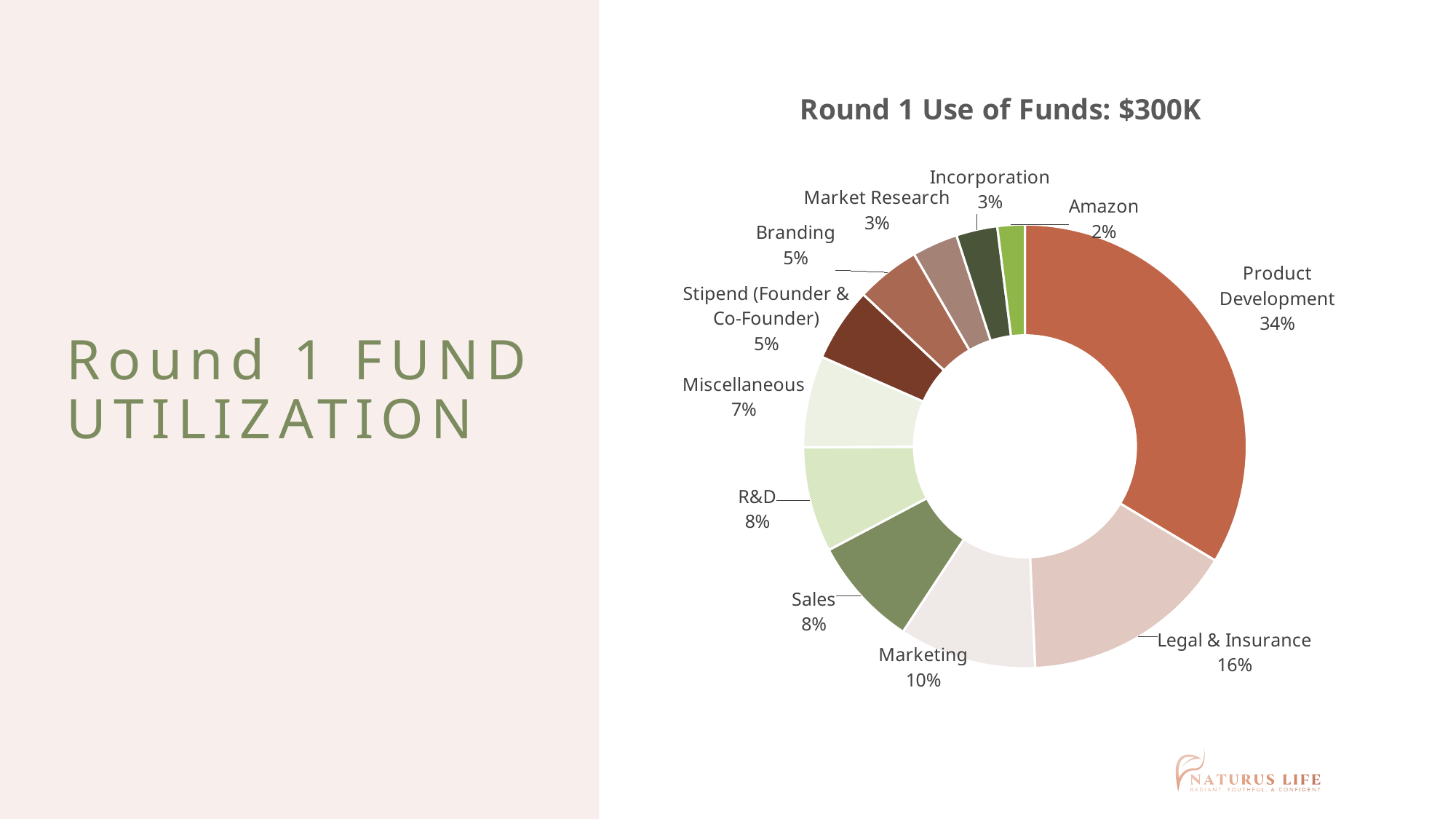
Which receives a larger share of funds, Marketing or Miscellaneous? Marketing What percentage of the funds is allocated to Legal & Insurance? 16% What share of Round 1 funds goes to Product Development? 34% Which category receives the largest share of Round 1 funds? Product Development Which category receives the smallest share of Round 1 funds? Amazon What type of chart is shown on the slide? Doughnut chart What is the combined share of Sales and R&D? 16% What is the title of the chart? Round 1 Use of Funds: $300K What share of the funds is allocated to Marketing? 10% What percentage is allocated to Stipend (Founder & Co-Founder)? 5% How many categories are shown in the chart? 11 What is the difference in percentage points between Product Development and Legal & Insurance? 18%